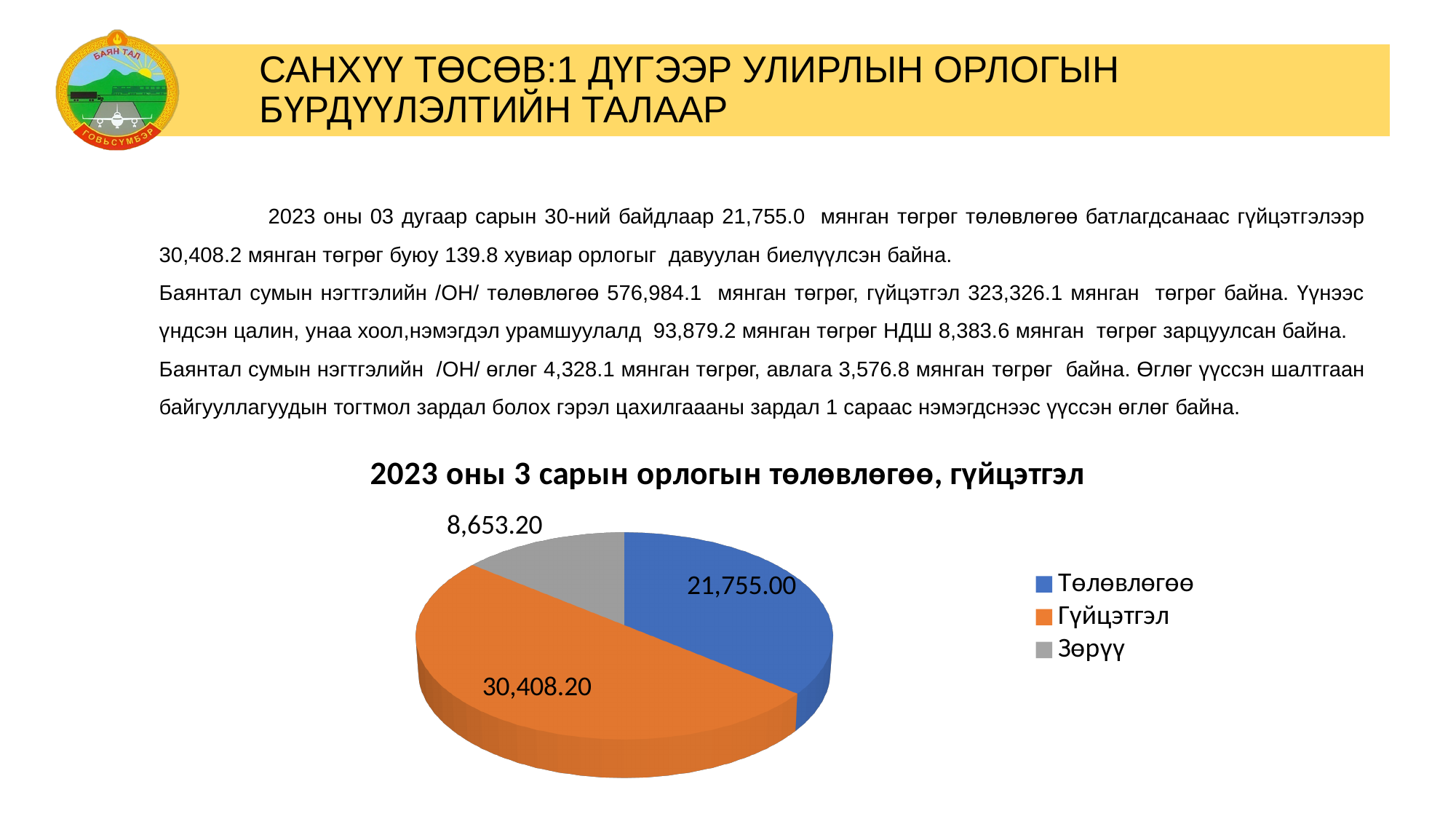
How many slices does the pie chart have? 3 What is the difference between the Төлөвлөгөө and Зөрүү values in the pie chart? 13,101.80 Which is larger in the pie chart, Төлөвлөгөө or Зөрүү? Төлөвлөгөө What is the value of the Төлөвлөгөө slice in the pie chart? 21,755.00 What is the title of the pie chart? 2023 оны 3 сарын орлогын төлөвлөгөө, гүйцэтгэл Which slice of the pie chart has the largest value? Гүйцэтгэл Which slice of the pie chart has the smallest value? Зөрүү What share of the pie does the Гүйцэтгэл slice represent? 50% What is the value of the Гүйцэтгэл slice in the pie chart? 30,408.20 What kind of chart is shown on the slide? Pie chart What is the value of the Зөрүү slice in the pie chart? 8,653.20 What is the difference between the Гүйцэтгэл and Төлөвлөгөө values in the pie chart? 8,653.20